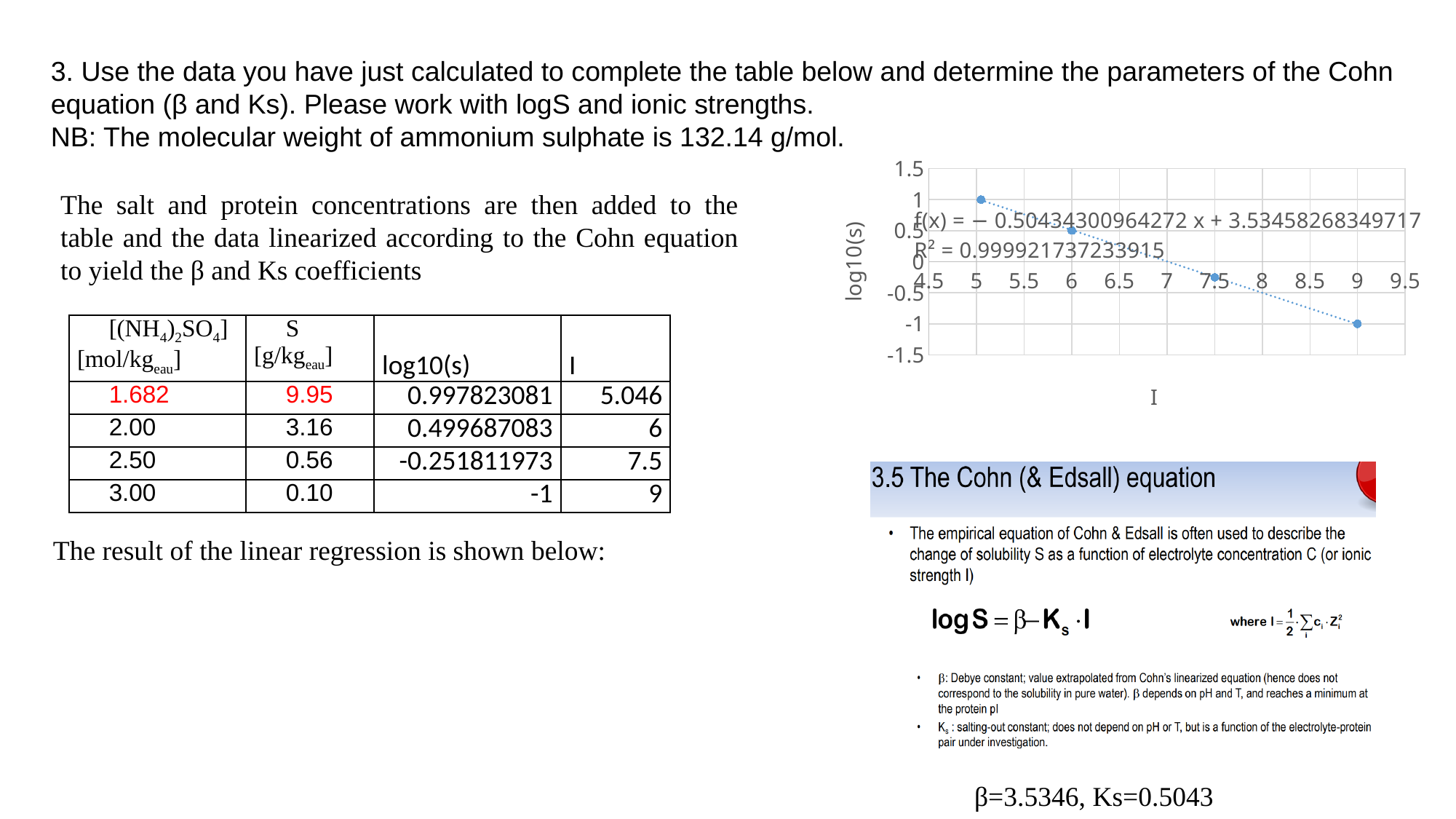
What R² value is printed on the chart for the trendline? 0.999921737233915 Is the log10(s) value of the point at I = 9 greater or less than -0.5? less Is the log10(s) value of the point at I = 6 greater or less than 0? greater Is the log10(s) value of the leftmost point (near I = 5) greater or less than 0.5? greater How many data points are plotted on the chart? 4 What is the label of the chart's vertical axis? log10(s) What is the log10(s) value of the point plotted at I = 9? -1 What kind of chart is shown on the slide? scatter chart Is the highest plotted point at the left end or the right end of the x axis? left end Do the plotted log10(s) values rise or fall as I increases along the x axis? fall Which point has the larger log10(s) value: the one at I = 6 or the one at I = 7.5? the one at I = 6